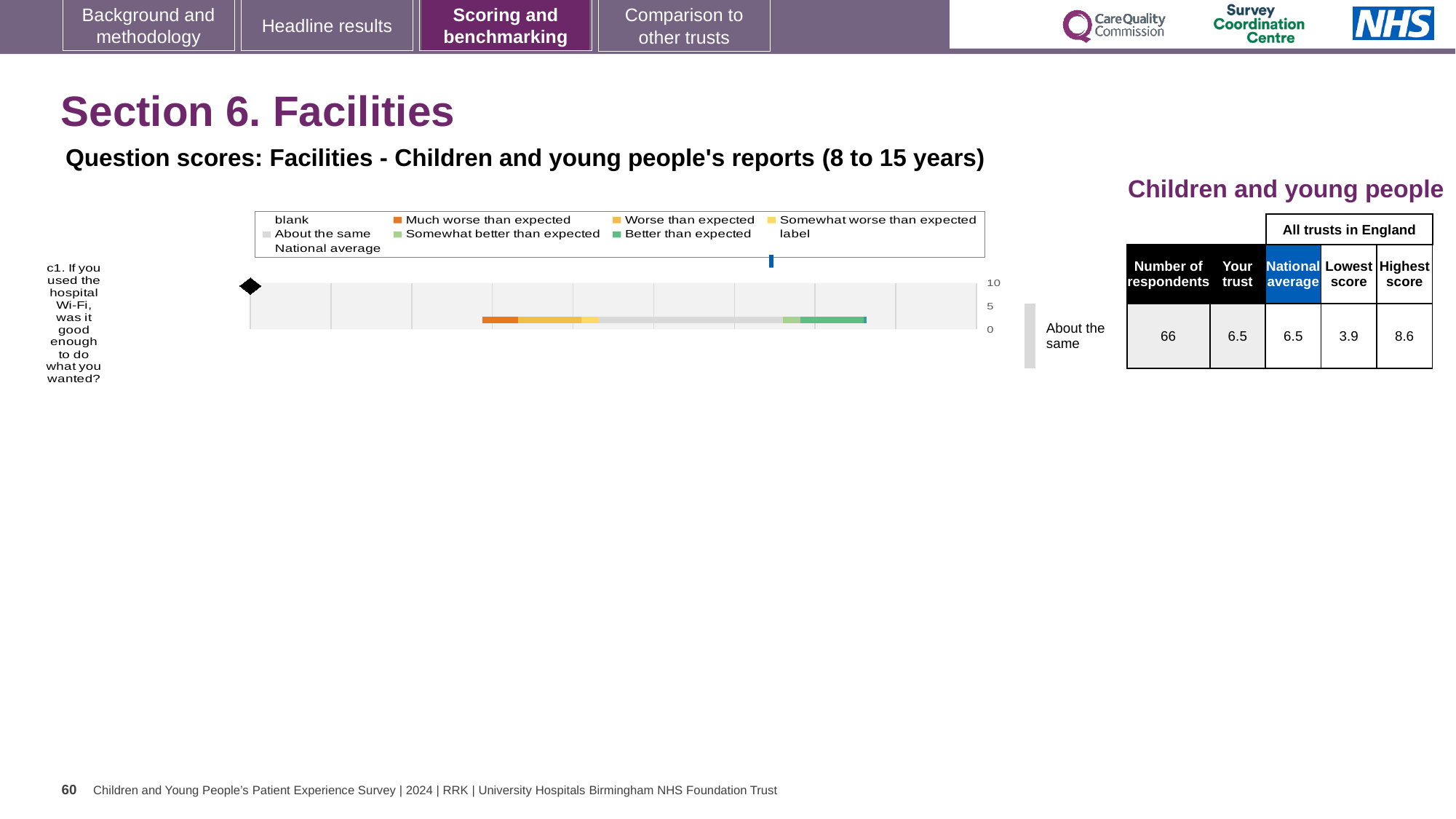
What is the lowest score among all trusts in England for question c1? 3.9 Which legend entry is shown in orange in the chart? Much worse than expected Which benchmark category is the trust's result for question c1 placed in? About the same How many respondents answered question c1? 66 What is the highest score among all trusts in England for question c1? 8.6 How many survey questions are plotted in the chart? 1 What is the national average score for question c1? 6.5 What is the 'Your trust' score for question c1 about the hospital Wi-Fi? 6.5 What is the difference between the highest score and the lowest score for question c1? 4.7 What kind of chart is used to show the question score for c1 on this slide? bar chart Is the trust's score for question c1 higher than, lower than, or the same as the national average? the same